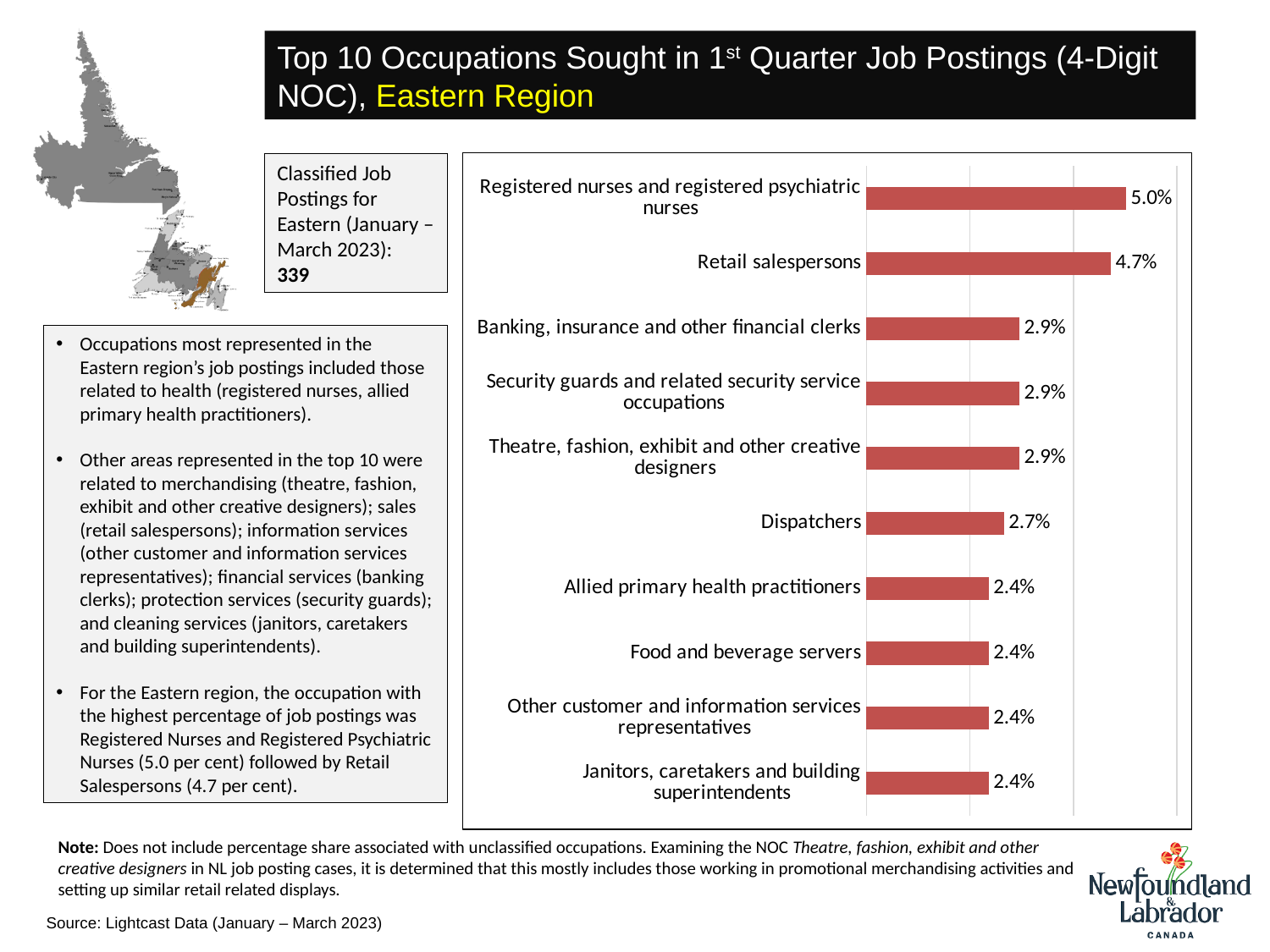
What percentage of job postings is shown for Registered nurses and registered psychiatric nurses? 5.0% Which is larger, the value for Dispatchers or the value for Food and beverage servers? Dispatchers What is the value for Retail salespersons? 4.7% How many occupations are shown in the chart? 10 What is the difference between the values for Retail salespersons and Banking, insurance and other financial clerks? 1.8% What colour are the bars in the chart? Red What is the difference between the values for Registered nurses and registered psychiatric nurses and Retail salespersons? 0.3% Which occupation has the highest percentage of job postings? Registered nurses and registered psychiatric nurses What is the value for Dispatchers? 2.7% What kind of chart is shown on the slide? Bar chart What is the value for Janitors, caretakers and building superintendents? 2.4% What is the value for Allied primary health practitioners? 2.4%